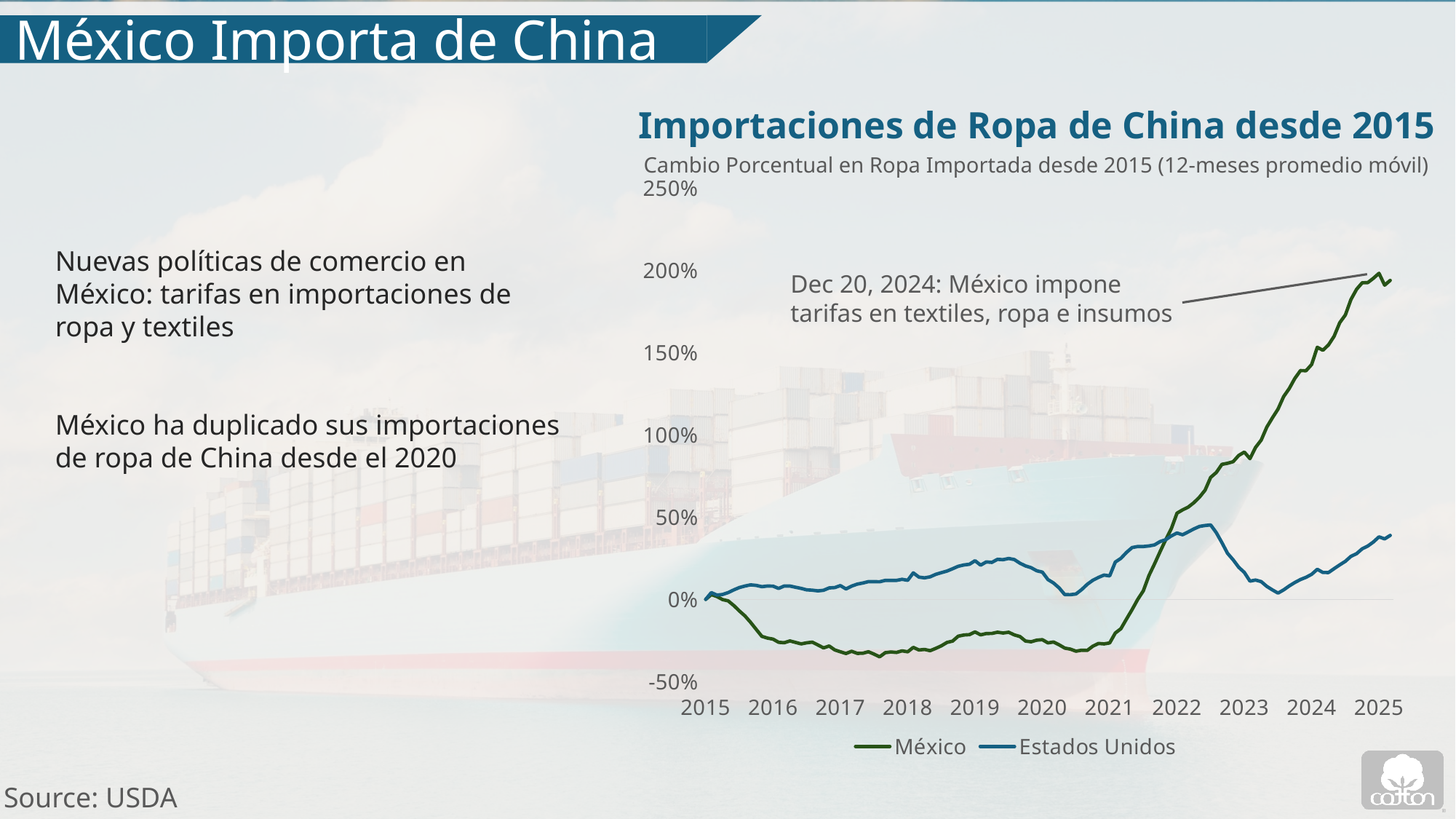
Is the value for Estados Unidos at 2025 greater or less than 50%? less What are the two series named in the chart legend? México and Estados Unidos What kind of chart is shown on the slide? line chart Is the value for México at 2018 greater or less than 0%? less What is the title of the chart? Importaciones de Ropa de China desde 2015 Does the México line rise or fall between 2021 and 2025? rise At 2025, which series has the larger value, México or Estados Unidos? México At 2018, which series has the larger value, México or Estados Unidos? Estados Unidos Is the value for México at 2024 greater or less than 100%? greater How many series does the chart legend list? 2 How many year labels are shown on the x axis? 11